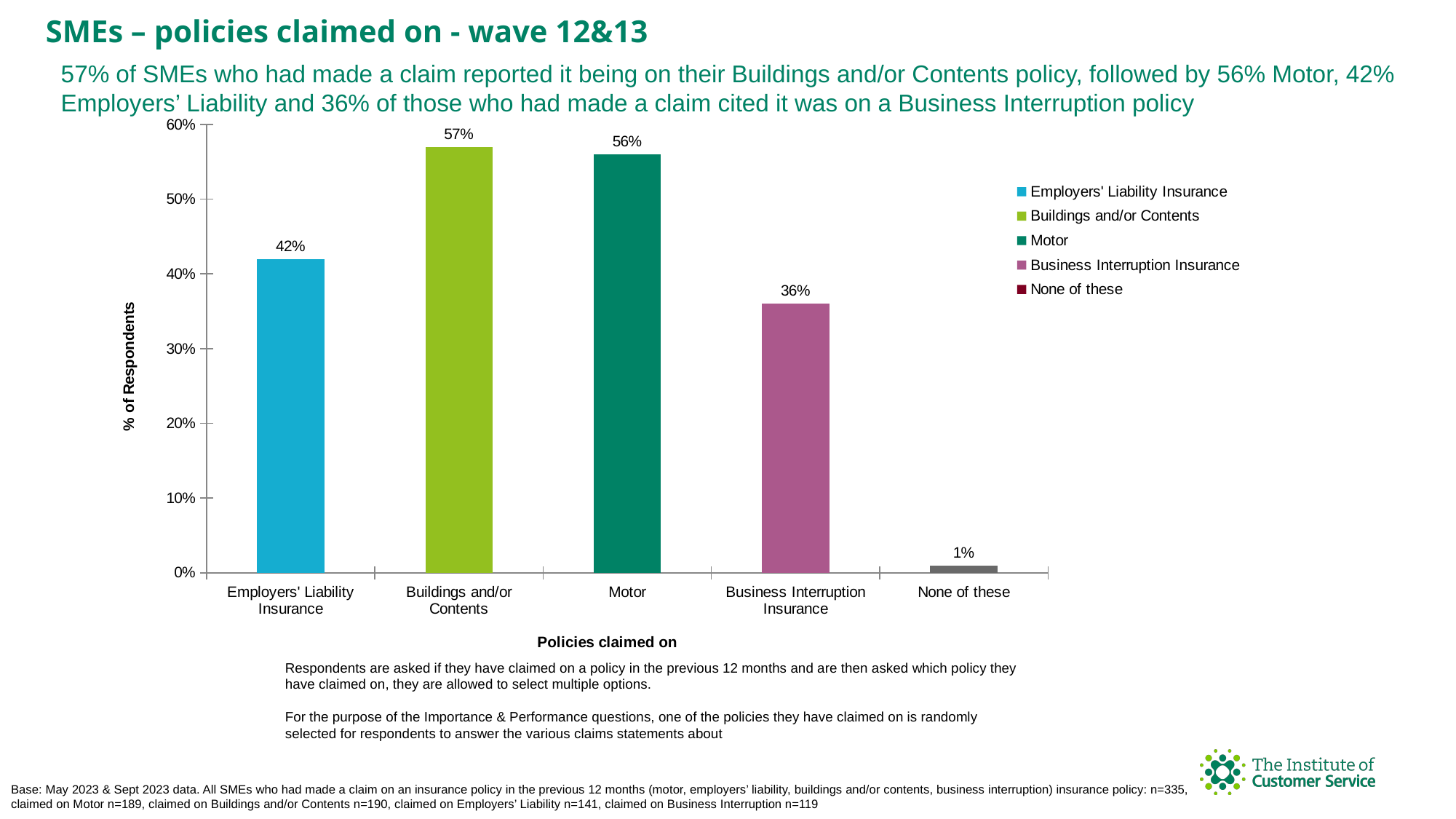
What percentage of respondents claimed on Employers' Liability Insurance? 42% How many categories are shown on the x axis of the chart? 5 What is the difference between the Buildings and/or Contents value and the Business Interruption Insurance value? 21 percentage points Which category has the lowest value in the chart? None of these What is the value shown for Business Interruption Insurance? 36% What is the label of the y axis? % of Respondents Which policy has the highest percentage of respondents claiming on it? Buildings and/or Contents How many entries does the legend list? 5 Is the value for Motor greater or less than 50%? greater Which is larger: the value for Motor or the value for Employers' Liability Insurance? Motor What type of chart is shown on the slide? Bar chart What percentage of respondents selected None of these? 1%